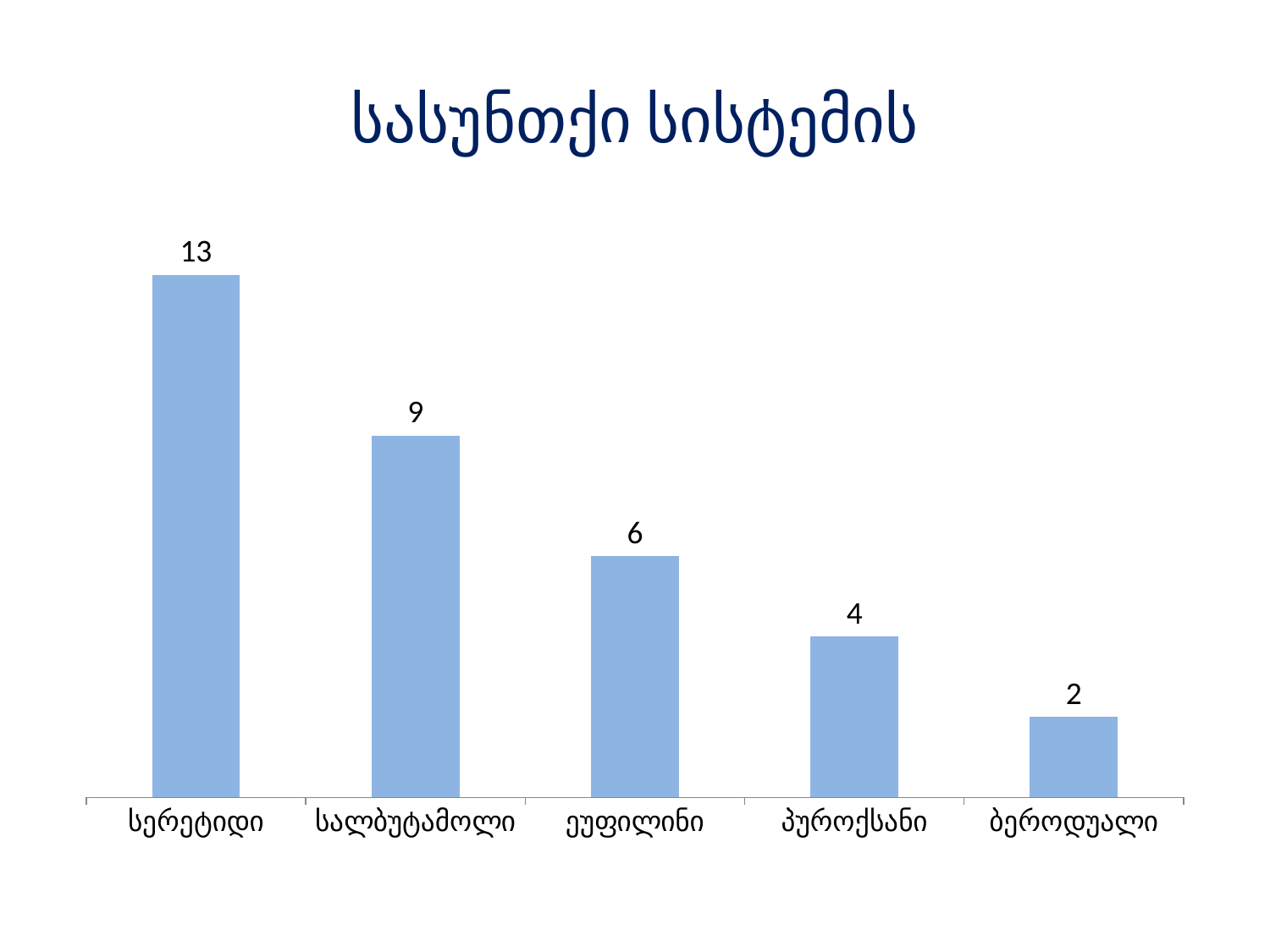
What is the value for ბეროდუალი? 2 What is the difference between the values for პუროქსანი and ბეროდუალი? 2 How many categories are shown in the chart? 5 What is the value for ეუფილინი? 6 What is the value for სერეტიდი? 13 What kind of chart is shown on the slide? Bar chart Which category has the lowest value? ბეროდუალი What is the value for სალბუტამოლი? 9 Do the values rise or fall from left to right along the x axis? Fall Which is larger, the value for ეუფილინი or the value for პუროქსანი? ეუფილინი Which category has the highest value? სერეტიდი What is the difference between the values for სერეტიდი and სალბუტამოლი? 4